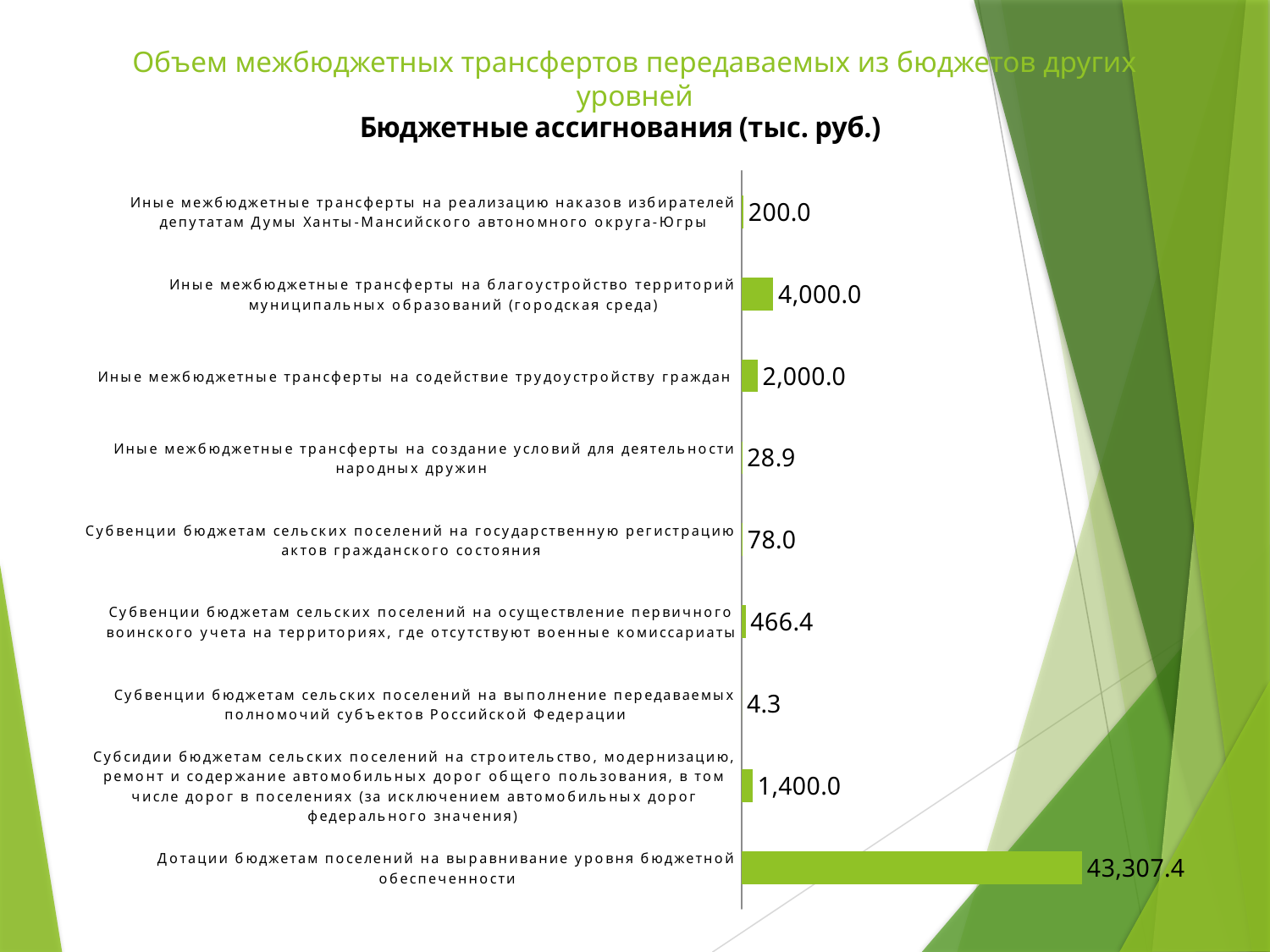
What is the value for "Дотации бюджетам поселений на выравнивание уровня бюджетной обеспеченности"? 43,307.4 Which category has the lowest value? Субвенции бюджетам сельских поселений на выполнение передаваемых полномочий субъектов Российской Федерации What is the title of the chart? Бюджетные ассигнования (тыс. руб.) What is the difference between the value for "Иные межбюджетные трансферты на благоустройство территорий муниципальных образований (городская среда)" and the value for "Иные межбюджетные трансферты на содействие трудоустройству граждан"? 2,000.0 What is the value for "Иные межбюджетные трансферты на создание условий для деятельности народных дружин"? 28.9 What is the value for "Иные межбюджетные трансферты на благоустройство территорий муниципальных образований (городская среда)"? 4,000.0 What is the value for "Иные межбюджетные трансферты на содействие трудоустройству граждан"? 2,000.0 How many categories are shown in the chart? 9 What type of chart is shown on the slide? bar chart Which is larger: the value for "Субвенции бюджетам сельских поселений на осуществление первичного воинского учета на территориях, где отсутствуют военные комиссариаты" or the value for "Иные межбюджетные трансферты на реализацию наказов избирателей депутатам Думы Ханты-Мансийского автономного округа-Югры"? Субвенции бюджетам сельских поселений на осуществление первичного воинского учета на территориях, где отсутствуют военные комиссариаты What is the value for "Субвенции бюджетам сельских поселений на выполнение передаваемых полномочий субъектов Российской Федерации"? 4.3 Which category has the highest value? Дотации бюджетам поселений на выравнивание уровня бюджетной обеспеченности